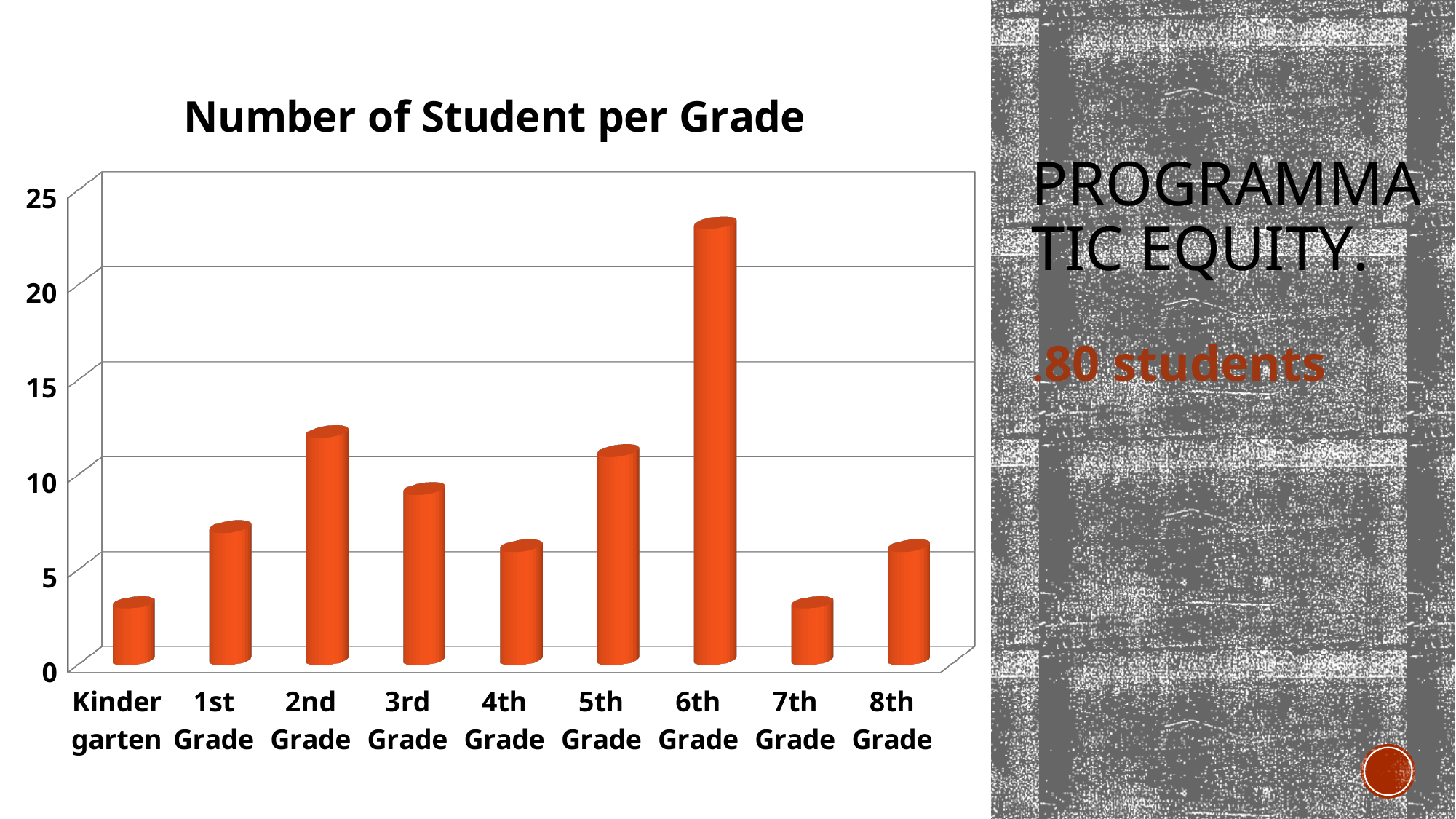
How many grade categories are shown on the x axis of the chart? 9 What colour are the bars in the chart? orange Is the value for Kindergarten greater or less than 5? less What is the title of the chart? Number of Student per Grade What kind of chart is shown on the slide? bar chart Is the value for 6th Grade greater or less than 20? greater Which grade has the highest number of students? 6th Grade Which has more students, 2nd Grade or 3rd Grade? 2nd Grade Which has more students, 5th Grade or 6th Grade? 6th Grade Is the value for 5th Grade greater or less than 15? less